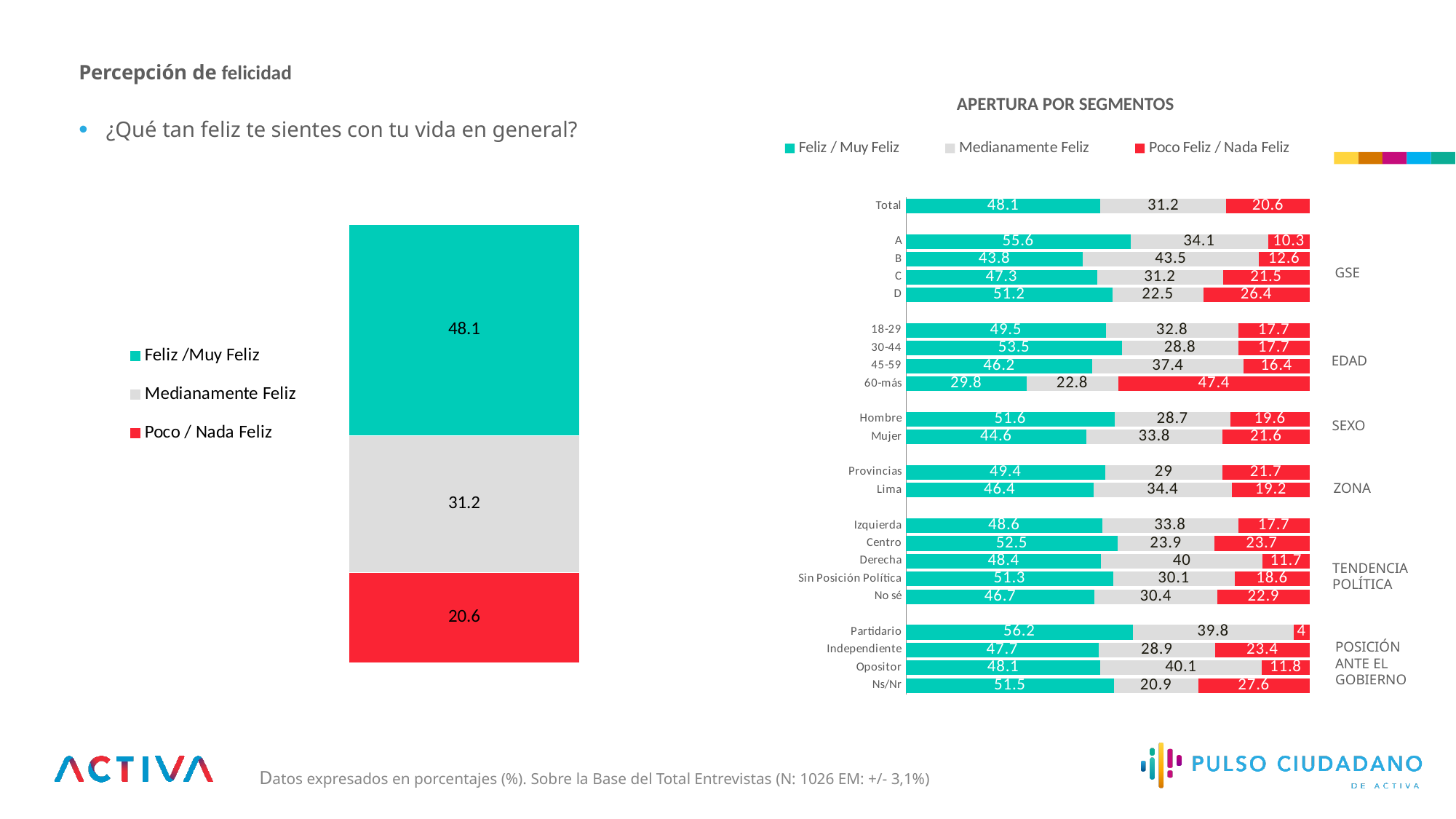
In the APERTURA POR SEGMENTOS chart, which category has the lowest Feliz / Muy Feliz value? 60-más In the left stacked bar chart, what is the difference between the Feliz /Muy Feliz value and the Medianamente Feliz value? 16.9 In the APERTURA POR SEGMENTOS chart, what is the Poco Feliz / Nada Feliz value for Partidario? 4 In the APERTURA POR SEGMENTOS chart, which has the larger Feliz / Muy Feliz value, Hombre or Mujer? Hombre In the APERTURA POR SEGMENTOS chart, what is the difference between the Medianamente Feliz values for Derecha and Centro? 16.1 In the APERTURA POR SEGMENTOS chart, which category has the highest Poco Feliz / Nada Feliz value? 60-más In the APERTURA POR SEGMENTOS chart, what is the total of the three values for the Lima bar? 100 In the left stacked bar chart, what is the value for Feliz /Muy Feliz? 48.1 In the left stacked bar chart, how many series does the legend list? 3 In the APERTURA POR SEGMENTOS chart, what is the Feliz / Muy Feliz value for the 60-más category? 29.8 In the left stacked bar chart, what is the value for Poco / Nada Feliz? 20.6 What kind of chart is the APERTURA POR SEGMENTOS chart? Stacked bar chart